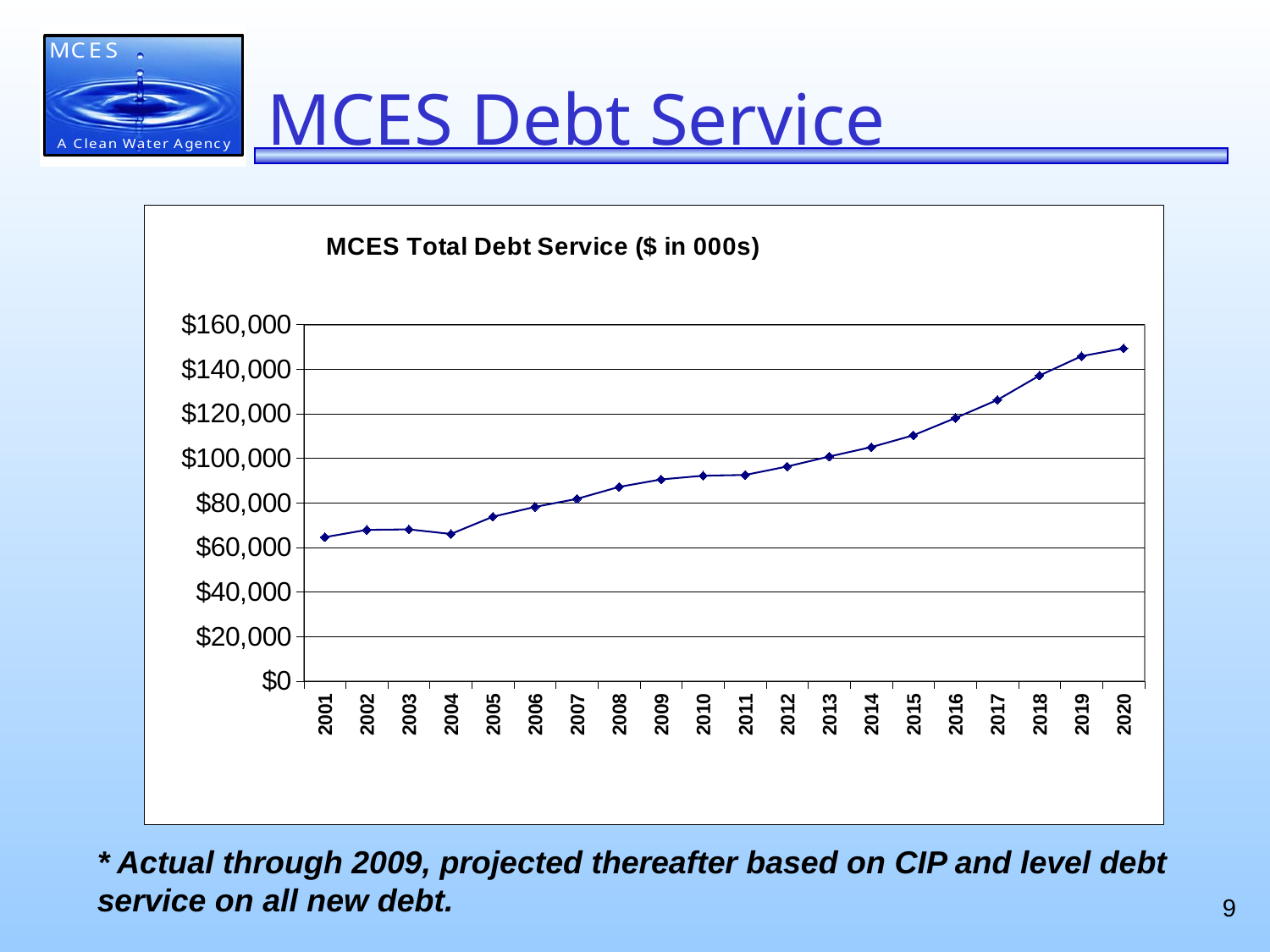
Which year has a larger total debt service, 2001 or 2020? 2020 Is the value for 2001 greater or less than $60,000? greater How many years are plotted on the x axis of the chart? 20 Which year has the highest total debt service? 2020 Do the values generally rise or fall from 2001 to 2020? rise Is the value for 2020 greater or less than $140,000? greater What is the title of the chart? MCES Total Debt Service ($ in 000s) Which year has the lowest total debt service? 2001 Which year has a larger total debt service, 2010 or 2005? 2010 What kind of chart is shown on the slide? line chart Is the value for 2005 greater or less than $80,000? less